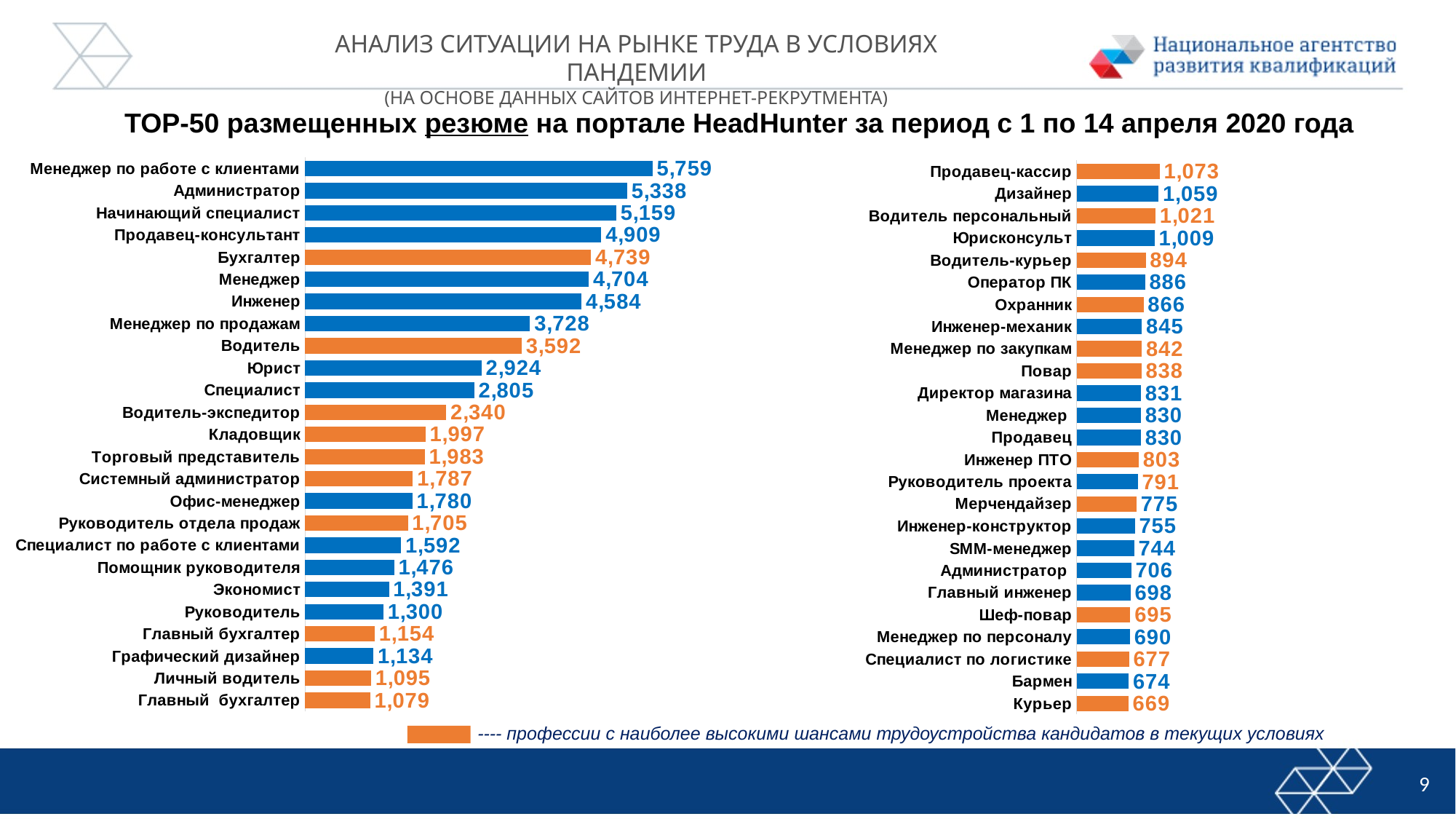
According to the legend, what do the orange bars represent? Профессии с наиболее высокими шансами трудоустройства кандидатов в текущих условиях In the right chart, what is the difference between Дизайнер and Юрисконсульт? 50 In the left chart, which category has the highest value? Менеджер по работе с клиентами In the left chart, how many resumes were posted for Менеджер по работе с клиентами? 5,759 In the right chart, which category has the lowest value? Курьер In the right chart, what is the value for Продавец-кассир? 1,073 In the left chart, which is larger: Водитель or Менеджер по продажам? Менеджер по продажам In the right chart, what is the value for Курьер? 669 In the left chart, what is the difference between Администратор and Начинающий специалист? 179 How many categories are shown in the left chart? 25 What type of chart is used on the slide? Bar chart In the left chart, what is the value for Бухгалтер? 4,739